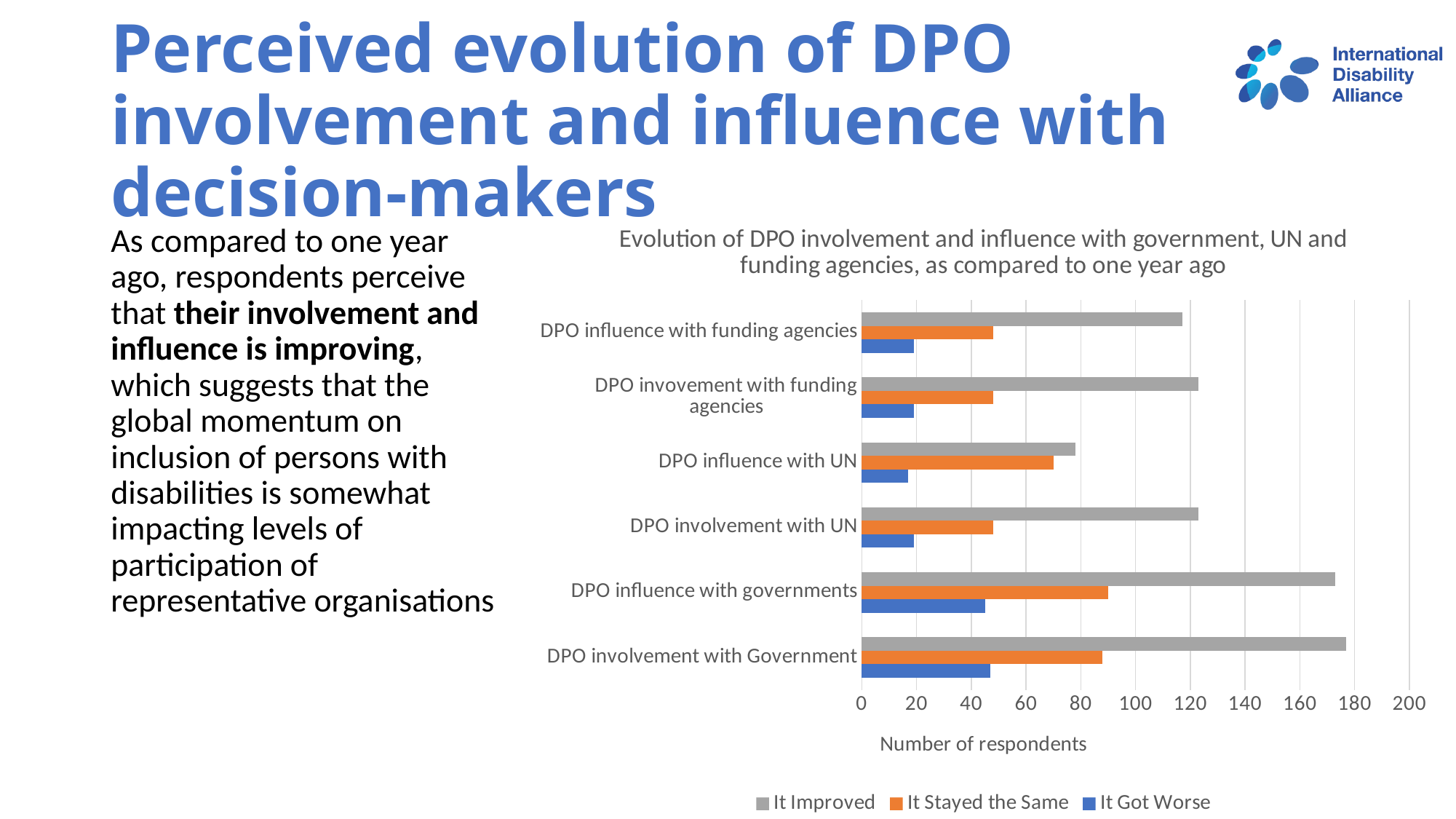
What colour represents the 'It Got Worse' series in the chart? Blue Which category has the highest value for the 'It Stayed the Same' series? DPO influence with governments How many series does the chart's legend list? 3 Is the 'It Improved' value for DPO influence with governments greater or less than 160? greater Which category has the lowest value for the 'It Improved' series? DPO influence with UN Which is larger: the 'It Stayed the Same' value for DPO influence with governments or for DPO influence with UN? DPO influence with governments Is the 'It Got Worse' value for DPO involvement with Government greater or less than 40? greater What is the title of the chart's horizontal axis? Number of respondents What kind of chart is shown on the slide? Bar chart How many categories are plotted on the chart? 6 Is the 'It Improved' value for DPO influence with UN greater or less than 100? less